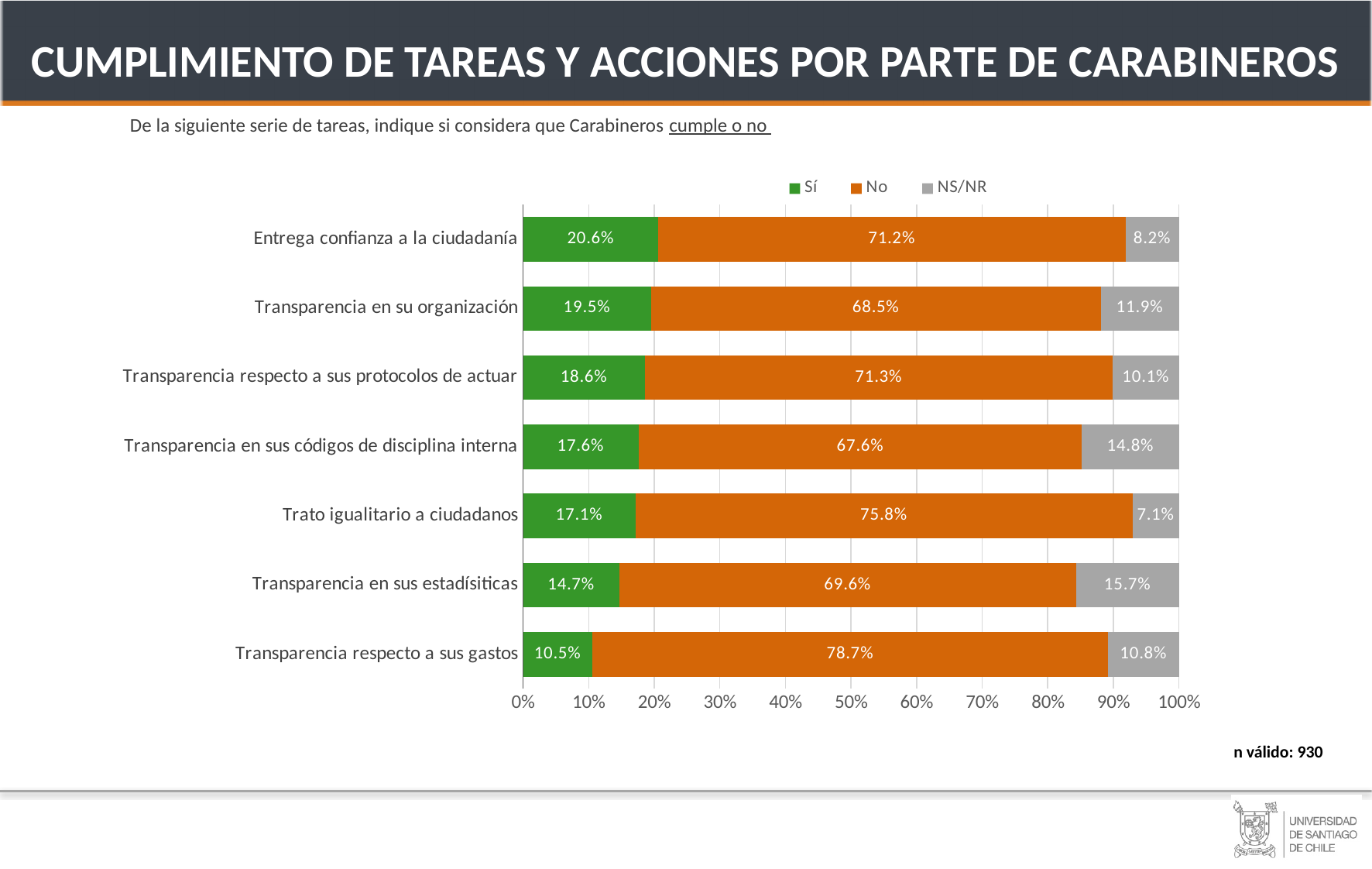
How many series does the legend list? 3 What is the difference between the 'No' values for 'Trato igualitario a ciudadanos' and 'Entrega confianza a la ciudadanía'? 4.6% Which category has the lowest 'NS/NR' value? Trato igualitario a ciudadanos What kind of chart is shown on the slide? Stacked bar chart How many categories are shown on the chart? 7 Which colour represents the 'No' series in the chart? Orange What is the 'Sí' value for 'Entrega confianza a la ciudadanía'? 20.6% Which category has the highest 'No' value? Transparencia respecto a sus gastos What is the 'NS/NR' value for 'Transparencia en sus estadísiticas'? 15.7% What is the 'No' value for 'Transparencia respecto a sus gastos'? 78.7% Which is larger: the 'Sí' value for 'Transparencia en su organización' or for 'Transparencia en sus códigos de disciplina interna'? Transparencia en su organización Which category has the lowest 'Sí' value? Transparencia respecto a sus gastos